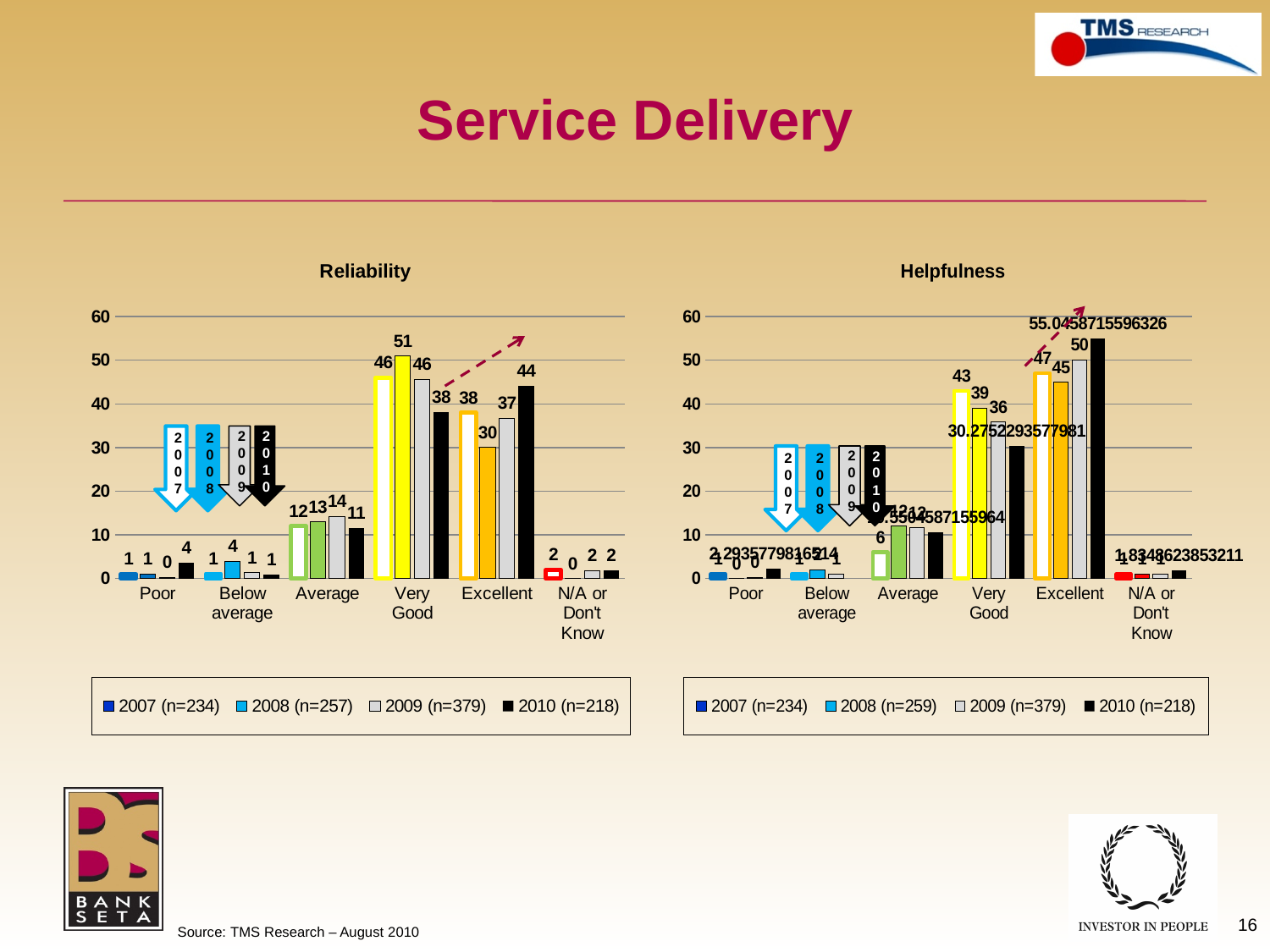
In the Reliability chart, what is the value for 2009 in the Average category? 14 In the Reliability chart, which year has the highest value in the Very Good category? 2008 In the Helpfulness chart, is the value for 2010 in the Excellent category greater or less than 50? greater In the Reliability chart, what is the difference between the 2008 and 2010 values in the Very Good category? 13 In the Helpfulness chart, what is the value for 2007 in the Very Good category? 43 In the Helpfulness chart, what is the value for 2009 in the Excellent category? 50 How many series does the legend of the Reliability chart list? 4 In the Reliability chart, what is the value for 2010 in the Excellent category? 44 In the Reliability chart, which is larger in the Excellent category: the 2007 value or the 2008 value? 2007 How many categories are shown on the x axis of the Reliability chart? 6 In the Reliability chart, what is the value for 2008 in the Very Good category? 51 What kind of chart is the Helpfulness chart? bar chart